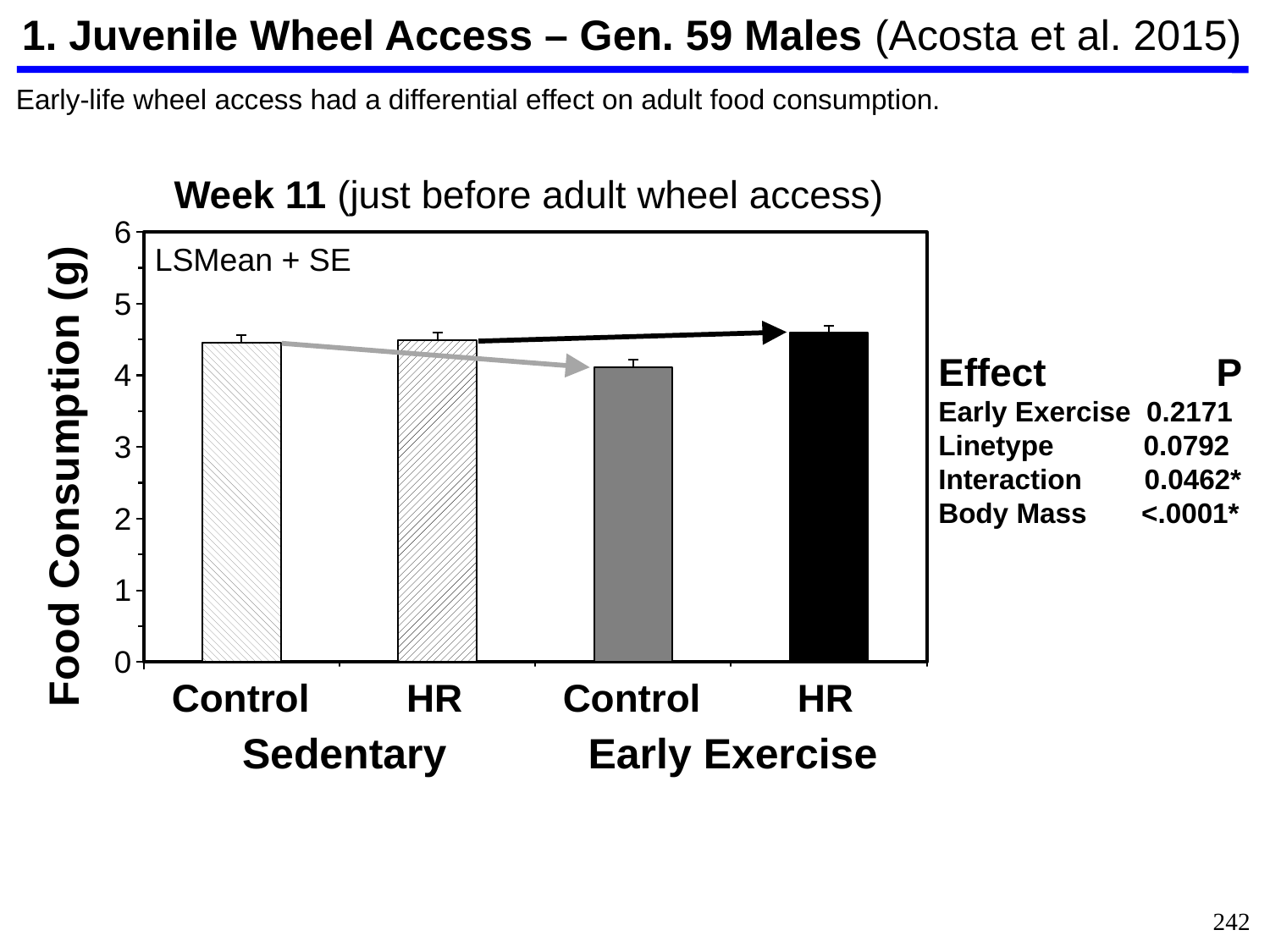
What kind of chart is shown on the slide? bar chart Within the Early Exercise group, which bar is higher, Control or HR? HR Which bar is higher, Sedentary Control or Early Exercise Control? Sedentary Control Which bar shows the lowest food consumption? Early Exercise Control Is the value for the Early Exercise HR bar greater or less than 4? greater What is the label of the y axis? Food Consumption (g) Is the value for the Sedentary Control bar greater or less than 4? greater How many bars are plotted in the chart? 4 What is the title of the chart? Week 11 (just before adult wheel access) Is the value for the Sedentary HR bar greater or less than 5? less